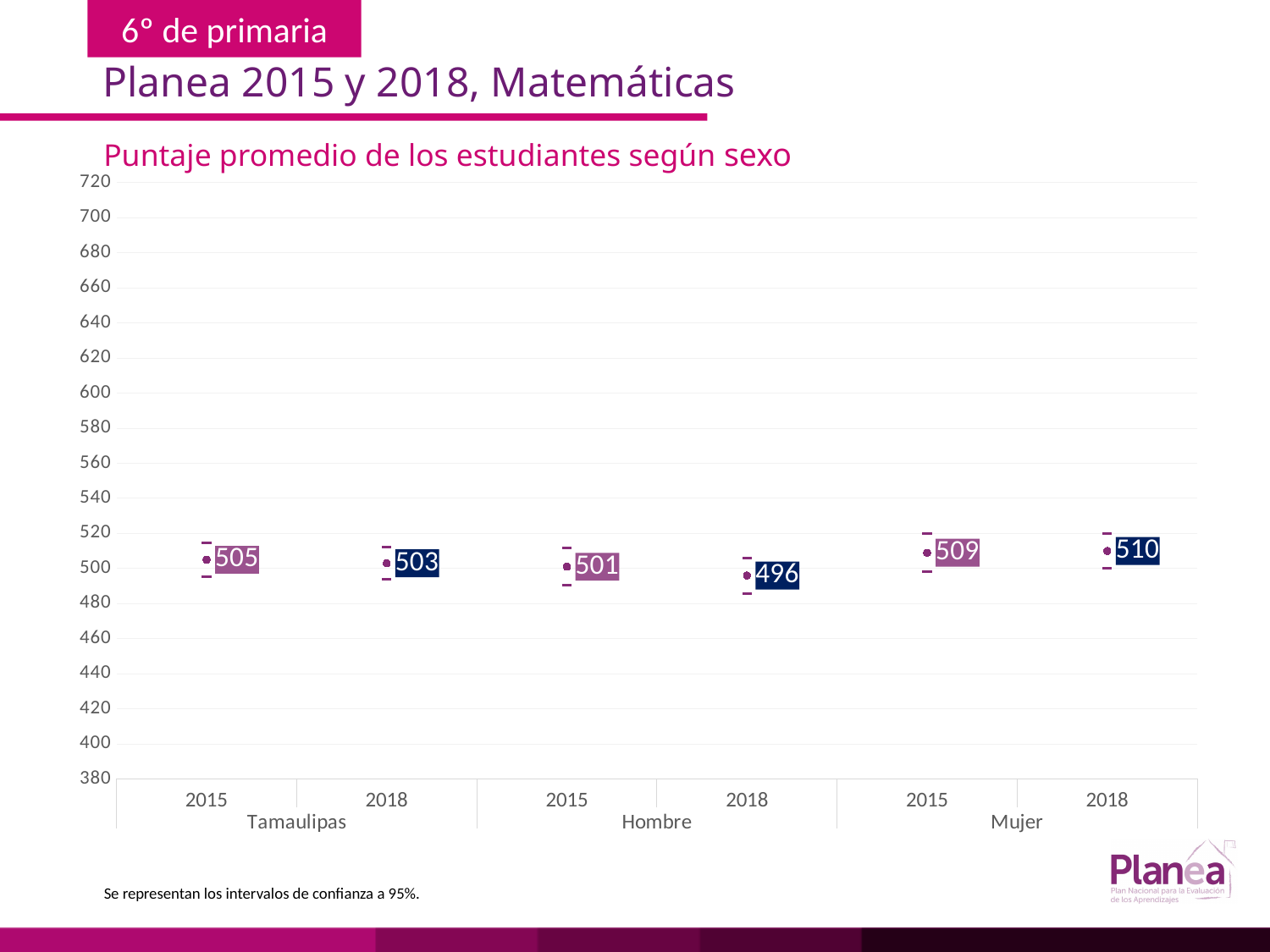
Which group and year has the highest average score? Mujer 2018 What is the title of the chart? Puntaje promedio de los estudiantes según sexo Did the Mujer score rise or fall from 2015 to 2018? rise What is the average score for Tamaulipas in 2015? 505 What is the difference between the Mujer 2015 score and the Hombre 2015 score? 8 By how much did the Hombre score change from 2015 to 2018? 5 What is the average score for Tamaulipas in 2018? 503 Which is larger, the Tamaulipas 2018 score or the Hombre 2018 score? Tamaulipas 2018 What is the average score for Mujer in 2018? 510 Which group and year has the lowest average score? Hombre 2018 What is the average score for Hombre in 2018? 496 How many data points are plotted on the chart? 6